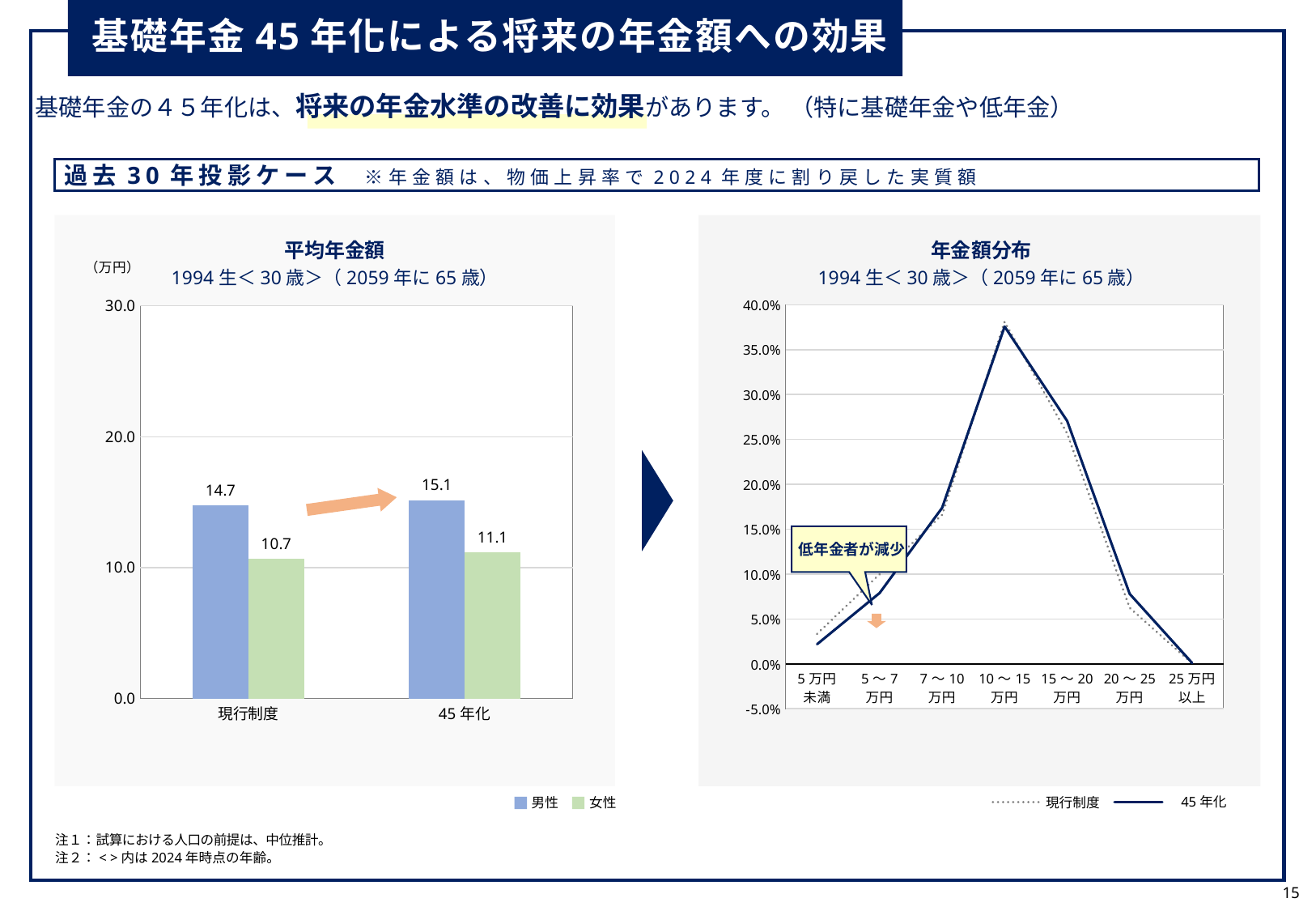
In the 平均年金額 chart on the left, what is the value for 女性 under 現行制度? 10.7 In the 年金額分布 chart on the right, how many categories are shown on the x axis? 7 What kind of chart is the 平均年金額 chart on the left? Bar chart In the 年金額分布 chart on the right, is the 45年化 value for 10～15万円 greater or less than 35.0%? greater In the 平均年金額 chart on the left, which bar is the highest? 男性 under 45年化 In the 平均年金額 chart on the left, what is the difference between the 男性 values for 45年化 and 現行制度? 0.4 In the 平均年金額 chart on the left, which is larger: 男性 under 45年化 or 男性 under 現行制度? 男性 under 45年化 In the 年金額分布 chart on the right, which series is drawn as a dotted line? 現行制度 In the 平均年金額 chart on the left, how many series does the legend list? 2 What kind of chart is the 年金額分布 chart on the right? Line chart In the 平均年金額 chart on the left, what is the value for 男性 under 現行制度? 14.7 In the 平均年金額 chart on the left, what is the value for 女性 under 45年化? 11.1